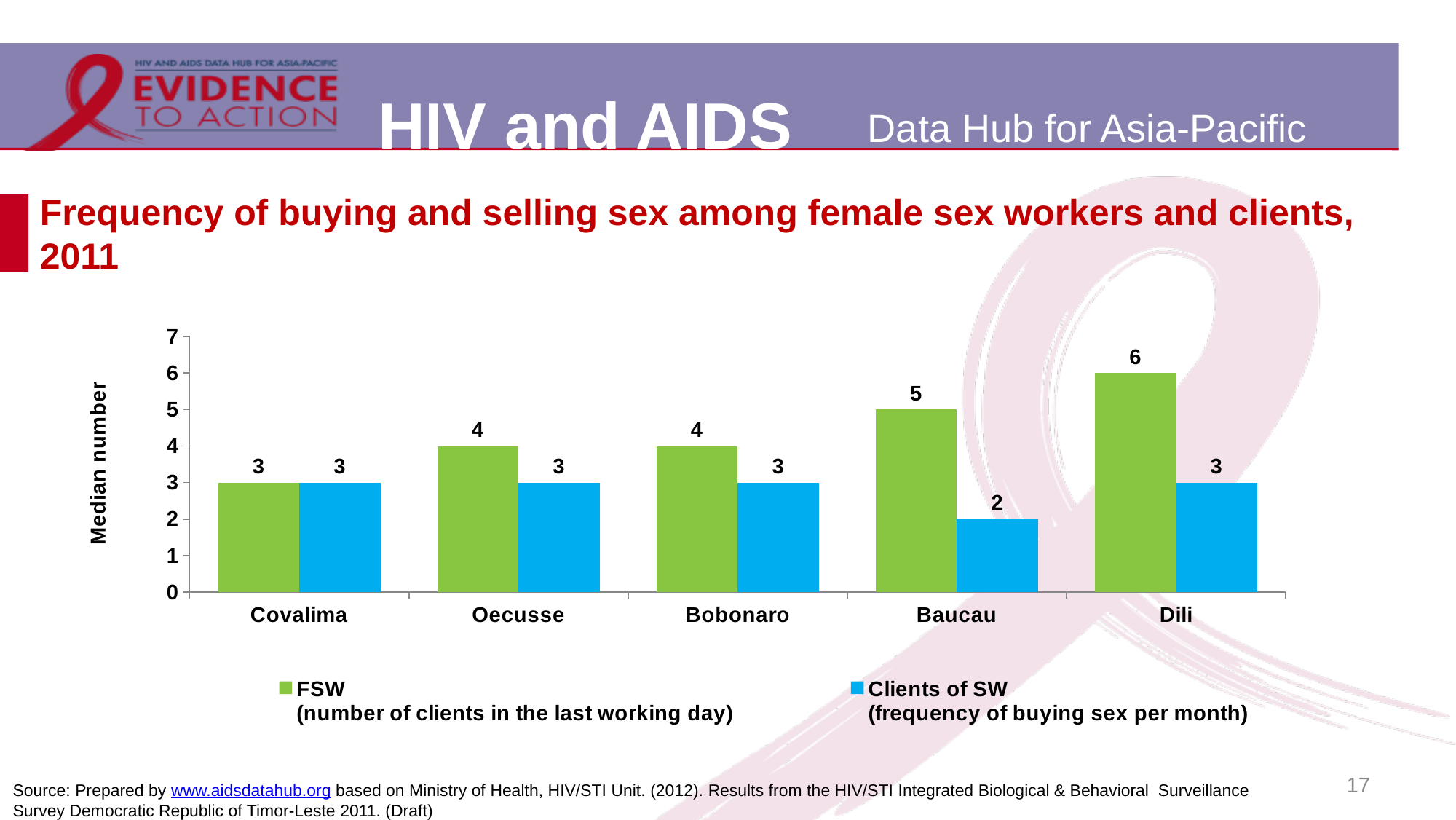
What is the y-axis label of the chart? Median number Which district has the highest FSW value? Dili What kind of chart is shown on the slide? Bar chart What is the difference between the FSW and Clients of SW values for Dili? 3 What is the FSW value for Dili? 6 How many series does the legend list? 2 What is the Clients of SW value for Baucau? 2 How many districts are shown on the x axis? 5 What is the difference between the FSW values for Baucau and Covalima? 2 Which district has the lowest Clients of SW value? Baucau Which is larger for Bobonaro, the FSW value or the Clients of SW value? FSW What is the FSW value for Oecusse? 4